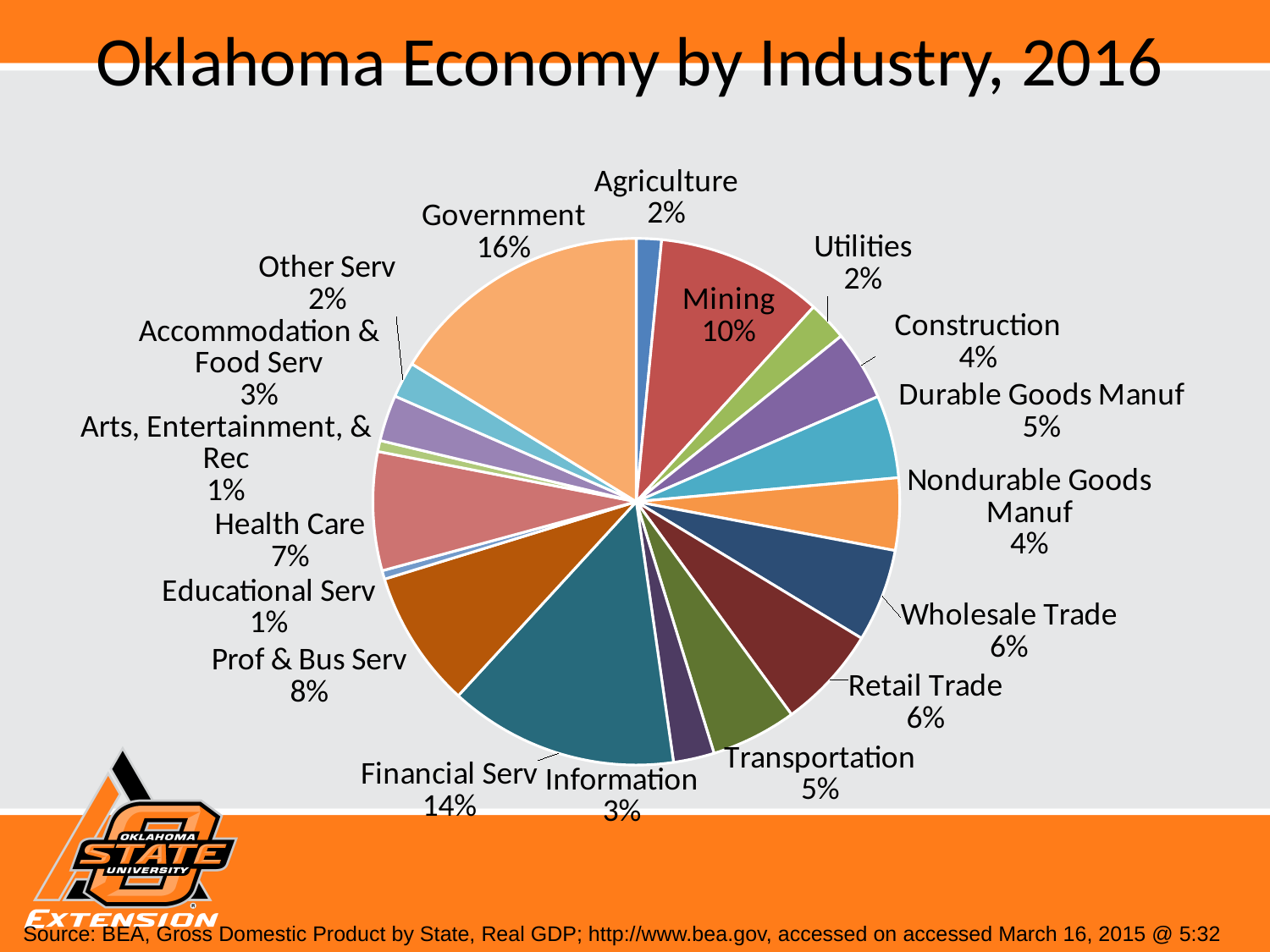
What is the difference in percentage points between Government and Financial Serv? 2 Which industry has the largest share of the pie? Government What share of the Oklahoma economy does Government account for? 16% What percentage is shown for Accommodation & Food Serv? 3% What percentage is shown for Mining? 10% What percentage is shown for Financial Serv? 14% What is the difference in percentage points between Mining and Prof & Bus Serv? 2 Which is larger, the share for Wholesale Trade or the share for Transportation? Wholesale Trade What is the title of the chart? Oklahoma Economy by Industry, 2016 What share is shown for Health Care? 7% How many industry categories are shown in the pie chart? 18 What type of chart is shown on the slide? pie chart